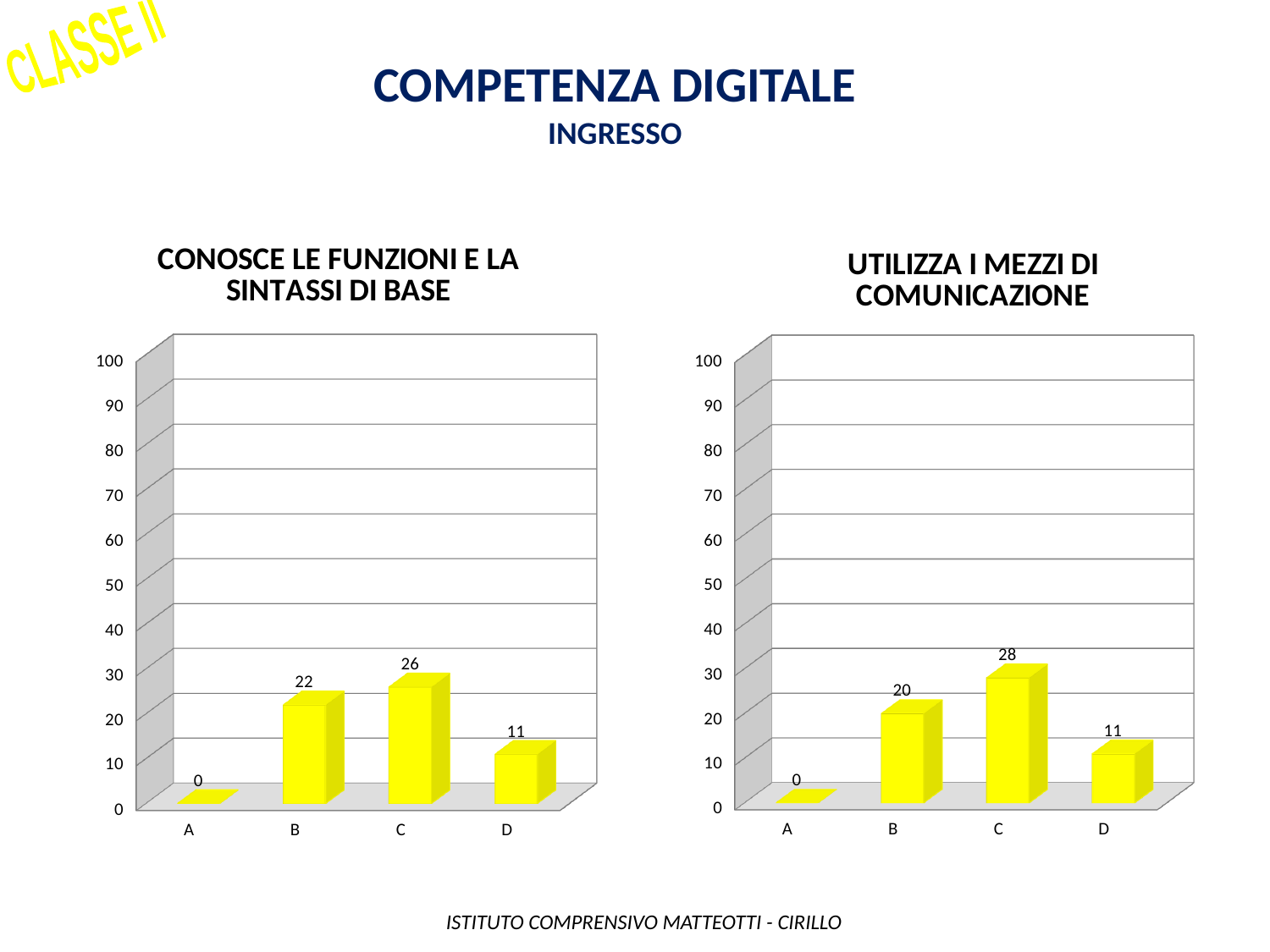
What kind of chart is the chart titled 'CONOSCE LE FUNZIONI E LA SINTASSI DI BASE'? bar chart In the chart titled 'CONOSCE LE FUNZIONI E LA SINTASSI DI BASE', what is the difference between the values for C and B? 4 How many categories are shown in the chart titled 'UTILIZZA I MEZZI DI COMUNICAZIONE'? 4 In the chart titled 'UTILIZZA I MEZZI DI COMUNICAZIONE', what is the value for category B? 20 In the chart titled 'CONOSCE LE FUNZIONI E LA SINTASSI DI BASE', is the value for B greater or less than 30? less What is the maximum value shown on the vertical axis of the chart titled 'UTILIZZA I MEZZI DI COMUNICAZIONE'? 100 In the chart titled 'CONOSCE LE FUNZIONI E LA SINTASSI DI BASE', which category has the highest value? C In the chart titled 'UTILIZZA I MEZZI DI COMUNICAZIONE', what is the difference between the values for C and D? 17 In the chart titled 'CONOSCE LE FUNZIONI E LA SINTASSI DI BASE', what is the value for category C? 26 In the chart titled 'CONOSCE LE FUNZIONI E LA SINTASSI DI BASE', what is the value for category D? 11 In the chart titled 'UTILIZZA I MEZZI DI COMUNICAZIONE', which is larger, the value for B or the value for D? B In the chart titled 'UTILIZZA I MEZZI DI COMUNICAZIONE', which category has the lowest value? A